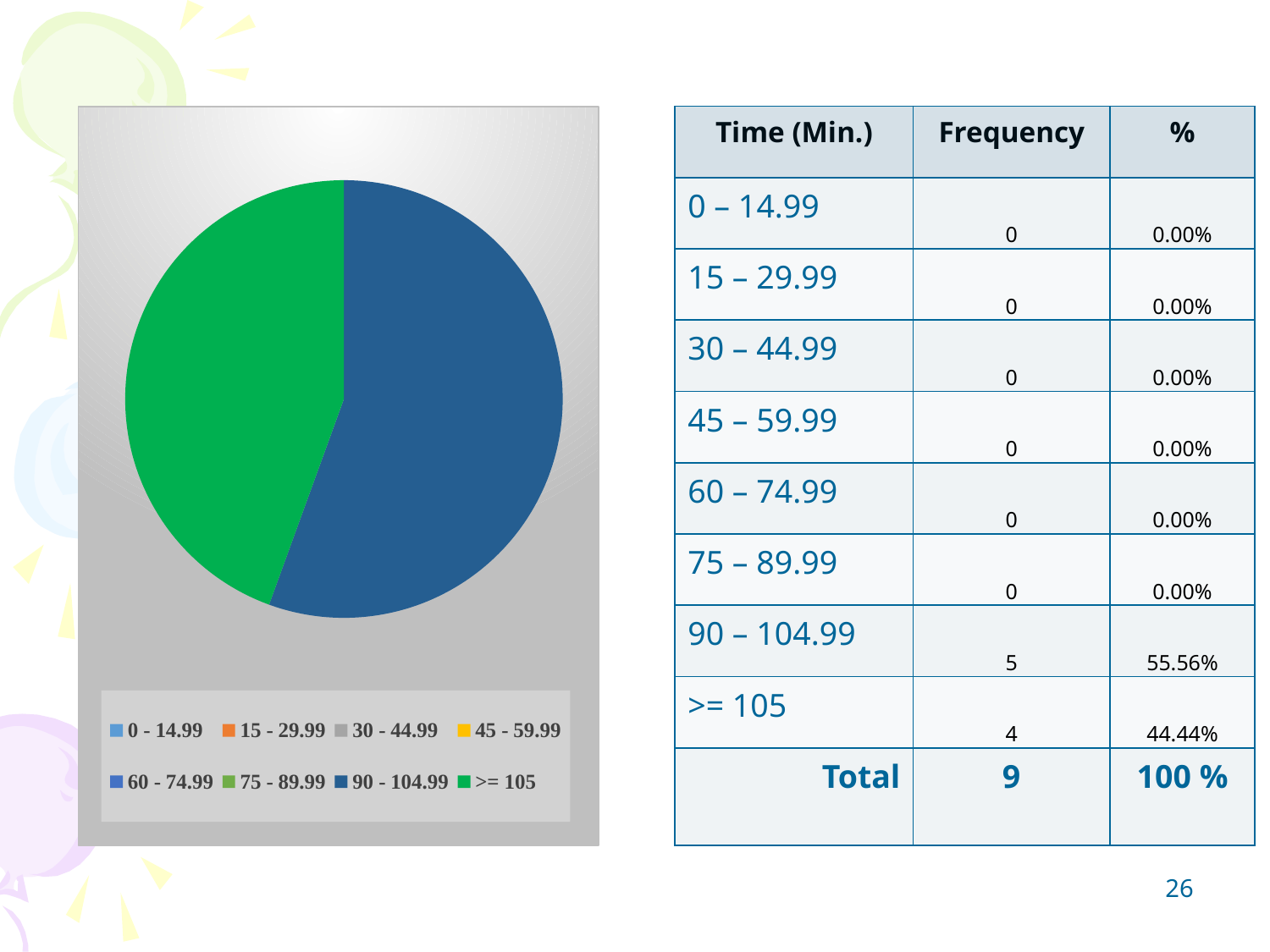
How many categories does the pie chart's legend list? 8 What colour is the >= 105 slice in the pie chart? green According to the table, what share of the pie does the 90 - 104.99 category represent? 55.56% What is the difference in frequency between the 90 - 104.99 and >= 105 intervals? 1 Which slice is larger in the pie chart, 90 - 104.99 or >= 105? 90 - 104.99 Which category has the largest slice in the pie chart? 90 - 104.99 What is the frequency for the >= 105 time interval in the table? 4 What is the total frequency shown in the table? 9 What kind of chart is shown on the slide? pie chart According to the table, what share of the pie does the >= 105 category represent? 44.44% What is the frequency for the 90 - 104.99 time interval in the table? 5 How many slices are visible in the pie chart? 2